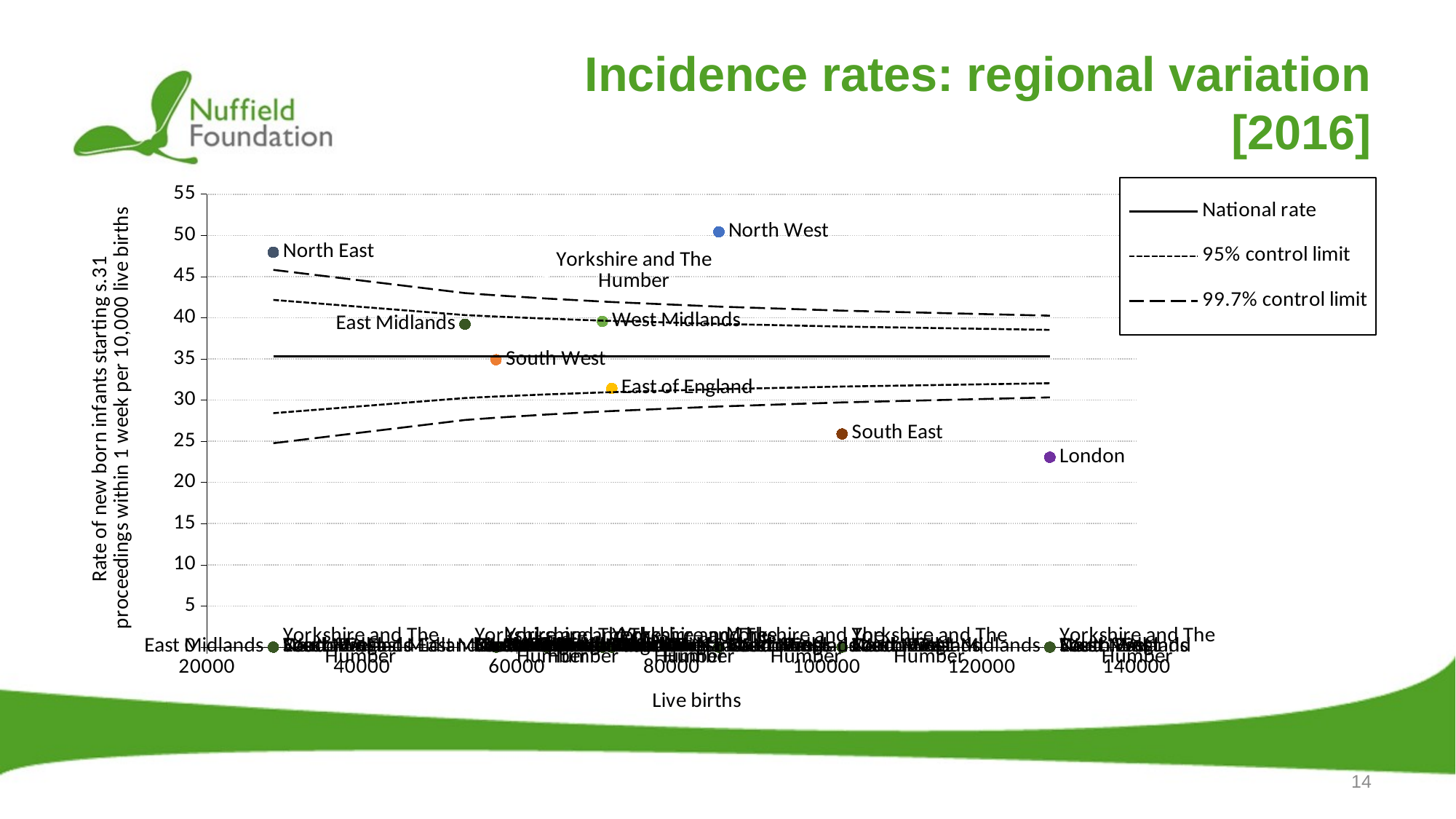
Is the rate for East of England greater or less than 35? less Is the rate for East Midlands greater or less than 35? greater Is the rate for North East greater or less than 45? greater What is the label of the x axis? Live births How many entries does the chart legend list? 3 Which has the higher rate, East of England or South East? East of England Which region has the highest rate of new born infants starting s.31 proceedings? North West Which region has the lowest rate of new born infants starting s.31 proceedings? London Which has the higher rate, North East or London? North East What kind of chart is shown on the slide? scatter chart